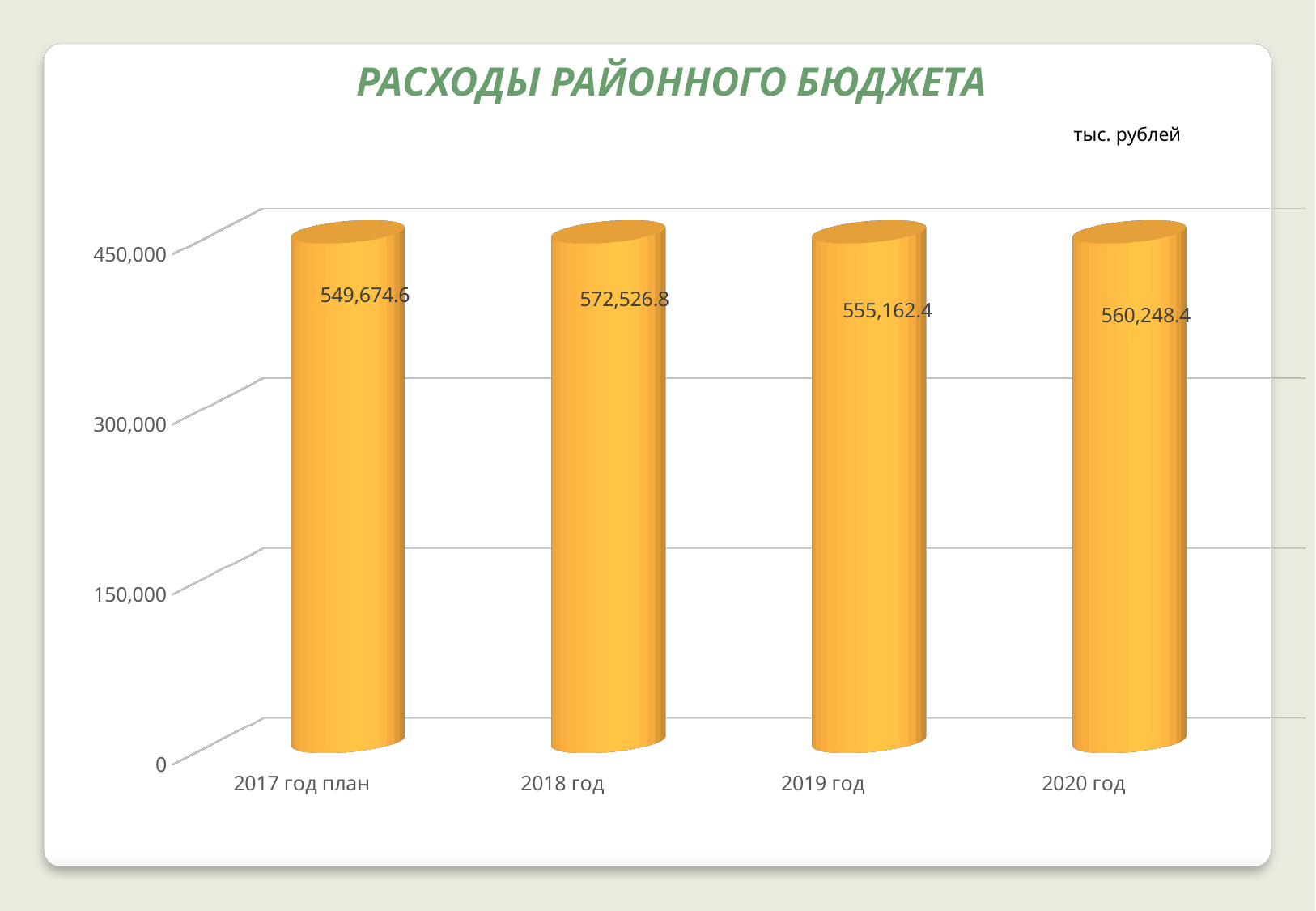
Which category has the lowest value? 2017 год план Which is larger, the value for 2019 год or the value for 2020 год? 2020 год Which category has the highest value? 2018 год What is the difference between the values for 2020 год and 2019 год? 5,086.0 What is the difference between the values for 2018 год and 2017 год план? 22,852.2 What is the title of the chart? РАСХОДЫ РАЙОННОГО БЮДЖЕТА What is the value for 2017 год план? 549,674.6 What is the value for 2020 год? 560,248.4 What is the value for 2019 год? 555,162.4 How many categories are shown on the x axis? 4 What is the value for 2018 год? 572,526.8 What kind of chart is shown on the slide? Bar chart